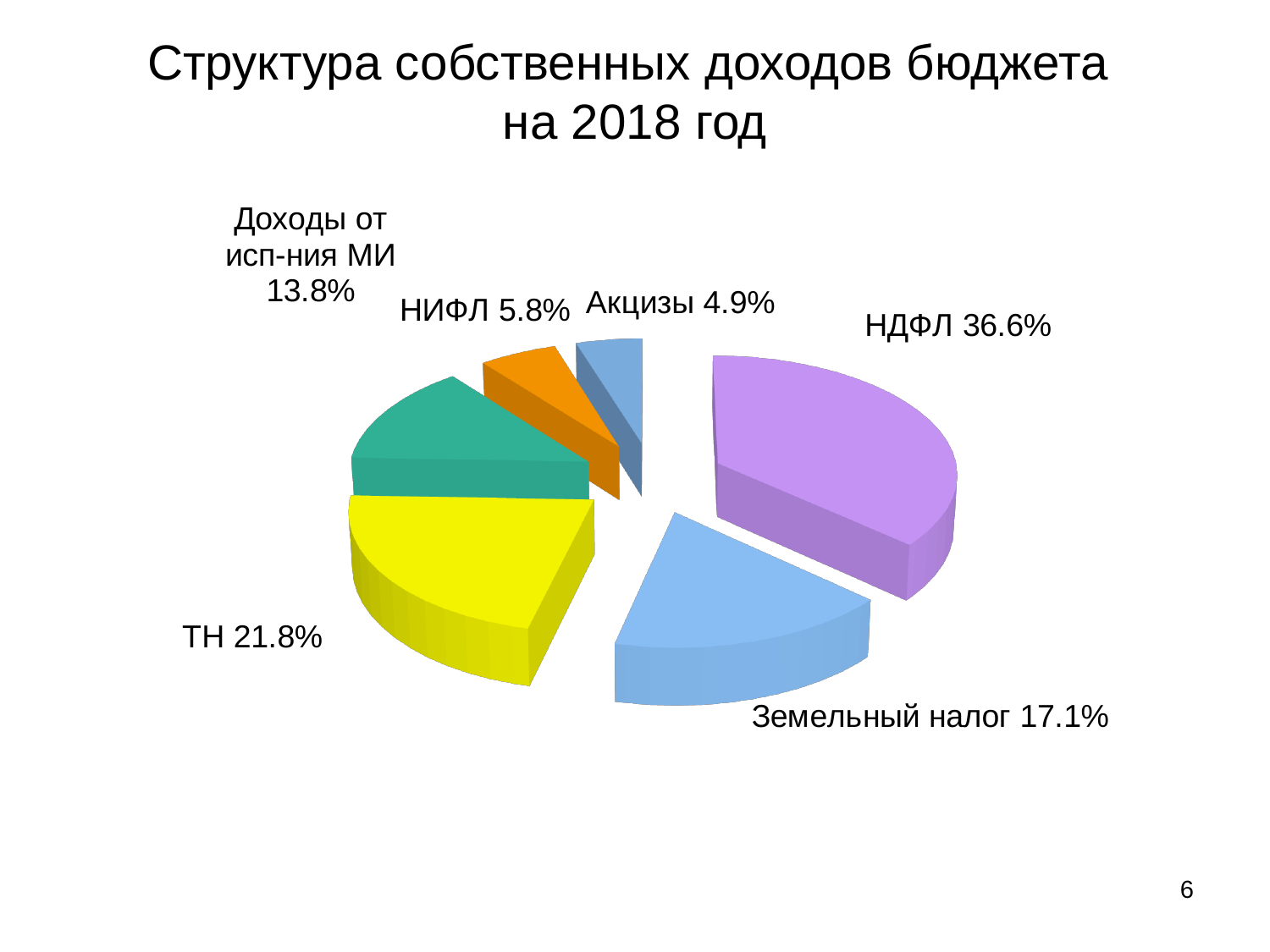
Which category has the smallest slice of the pie? Акцизы What is the difference in percentage points between НДФЛ and ТН? 14.8 What kind of chart is shown on the slide? Pie chart What share of the pie does Акцизы have? 4.9% How many slices does the pie chart have? 6 Which category has the largest slice of the pie? НДФЛ What is the title of the chart? Структура собственных доходов бюджета на 2018 год What share of the pie does Земельный налог have? 17.1% What share of the pie does НДФЛ have? 36.6% What share of the pie does Доходы от исп-ния МИ have? 13.8% What share of the pie does ТН have? 21.8% Which is larger, the share for Земельный налог or the share for Доходы от исп-ния МИ? Земельный налог